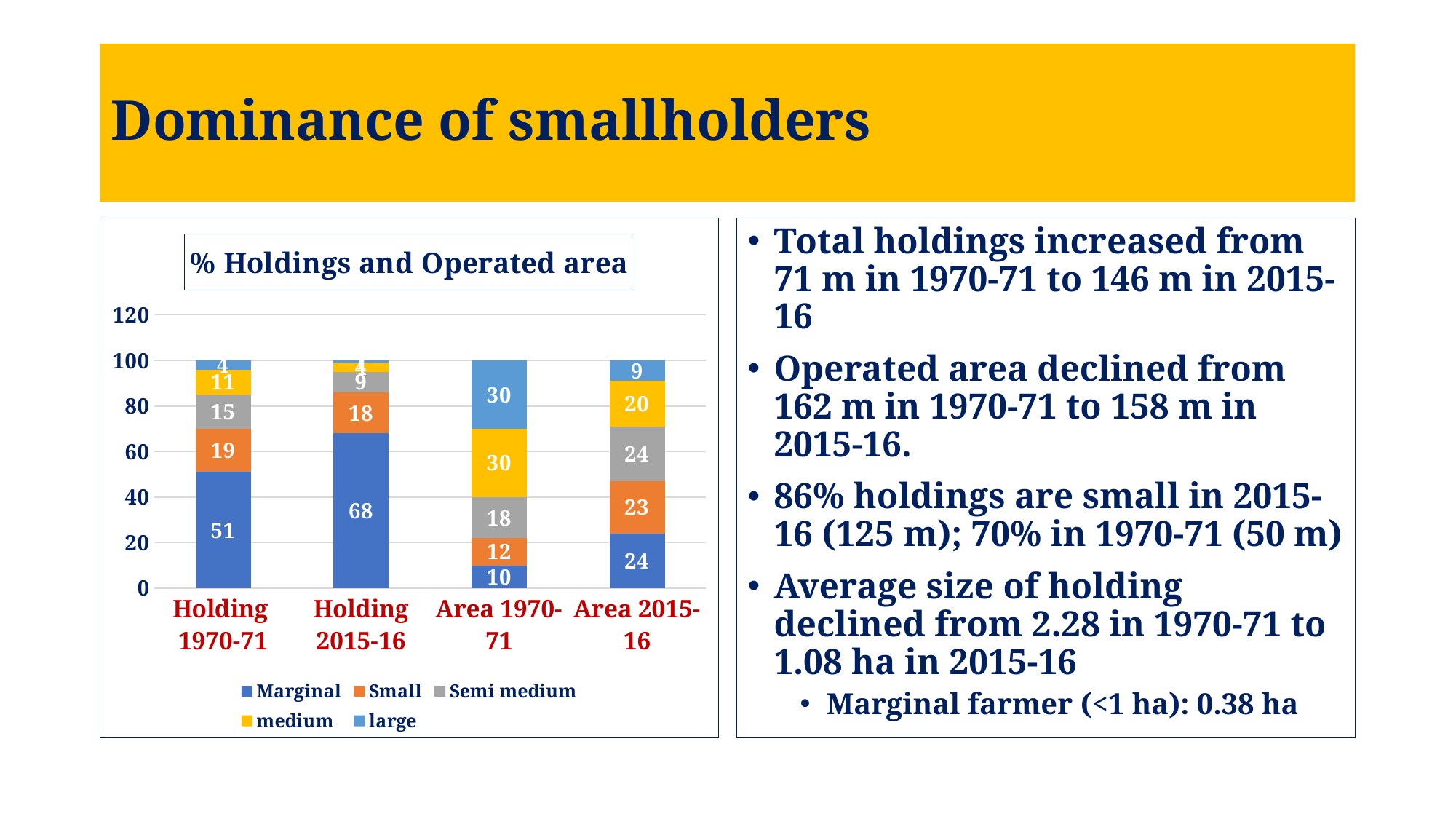
What kind of chart is shown on the slide? Stacked bar chart What is the difference between the Marginal values for Holding 2015-16 and Holding 1970-71? 17 Which category has the lowest Marginal value? Area 1970-71 What is the Small value for Area 2015-16? 23 What is the title of the chart? % Holdings and Operated area What is the large value for Area 1970-71? 30 What is the Marginal value for Holding 2015-16? 68 How many series does the chart legend list? 5 Which is larger, the medium value for Area 1970-71 or the medium value for Area 2015-16? Area 1970-71 What is the total of the stacked bar for Area 2015-16? 100 How many categories are shown on the x axis of the chart? 4 Which category has the highest Marginal value? Holding 2015-16